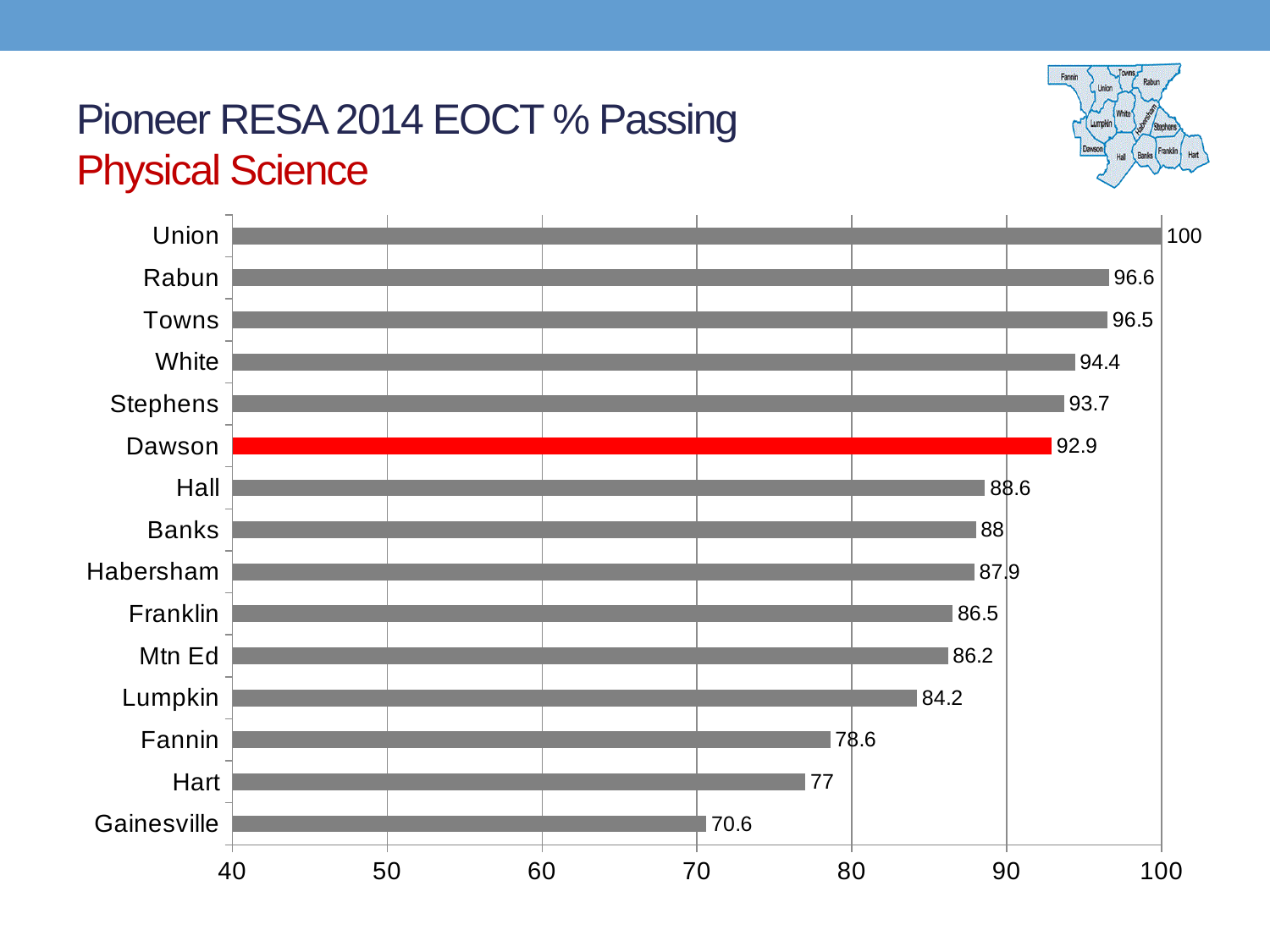
What is the difference between the values for Rabun and Towns? 0.1 What is the difference between the values for Union and Gainesville? 29.4 Which has a higher % passing, Hart or Fannin? Fannin Which bar is highlighted in red? Dawson Is the value for Lumpkin greater or less than 80? greater Which system has the highest % passing? Union What kind of chart is shown on the slide? bar chart What is the % passing value for Habersham? 87.9 Which system has the lowest % passing? Gainesville How many systems are shown on the chart? 15 What is the % passing value for Gainesville? 70.6 What is the % passing value for Dawson? 92.9